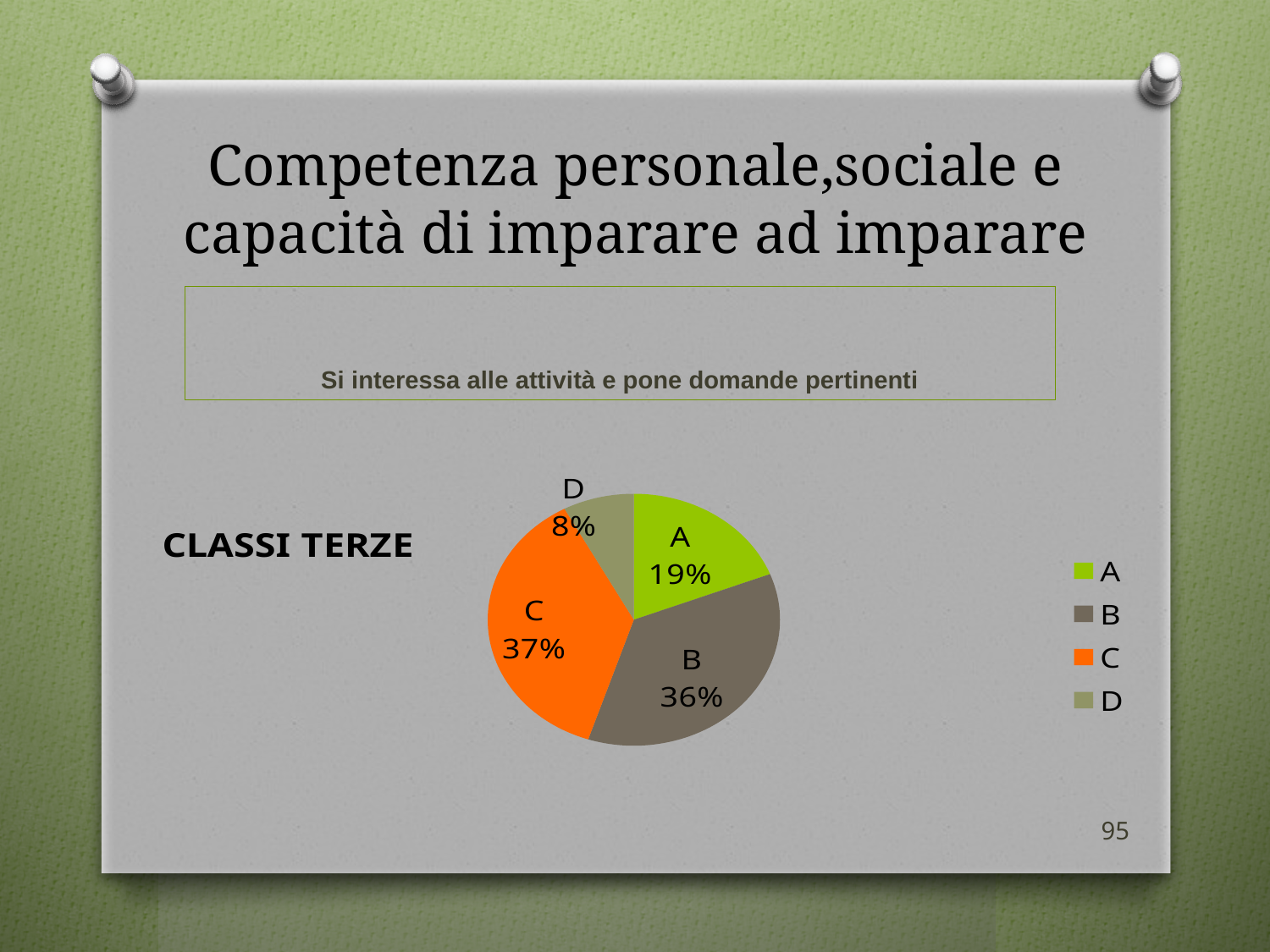
What kind of chart is shown on the slide? pie chart Which category has the smallest slice of the pie chart? D What percentage does slice B represent in the pie chart? 36% What percentage does slice D represent in the pie chart? 8% Which slice is larger, A or B? B Which category has the largest slice of the pie chart? C How many entries does the legend list? 4 What percentage does slice A represent in the pie chart? 19% What percentage does slice C represent in the pie chart? 37% What colour is slice C in the pie chart? orange What is the difference between the percentages for B and A? 17% How many slices does the pie chart have? 4